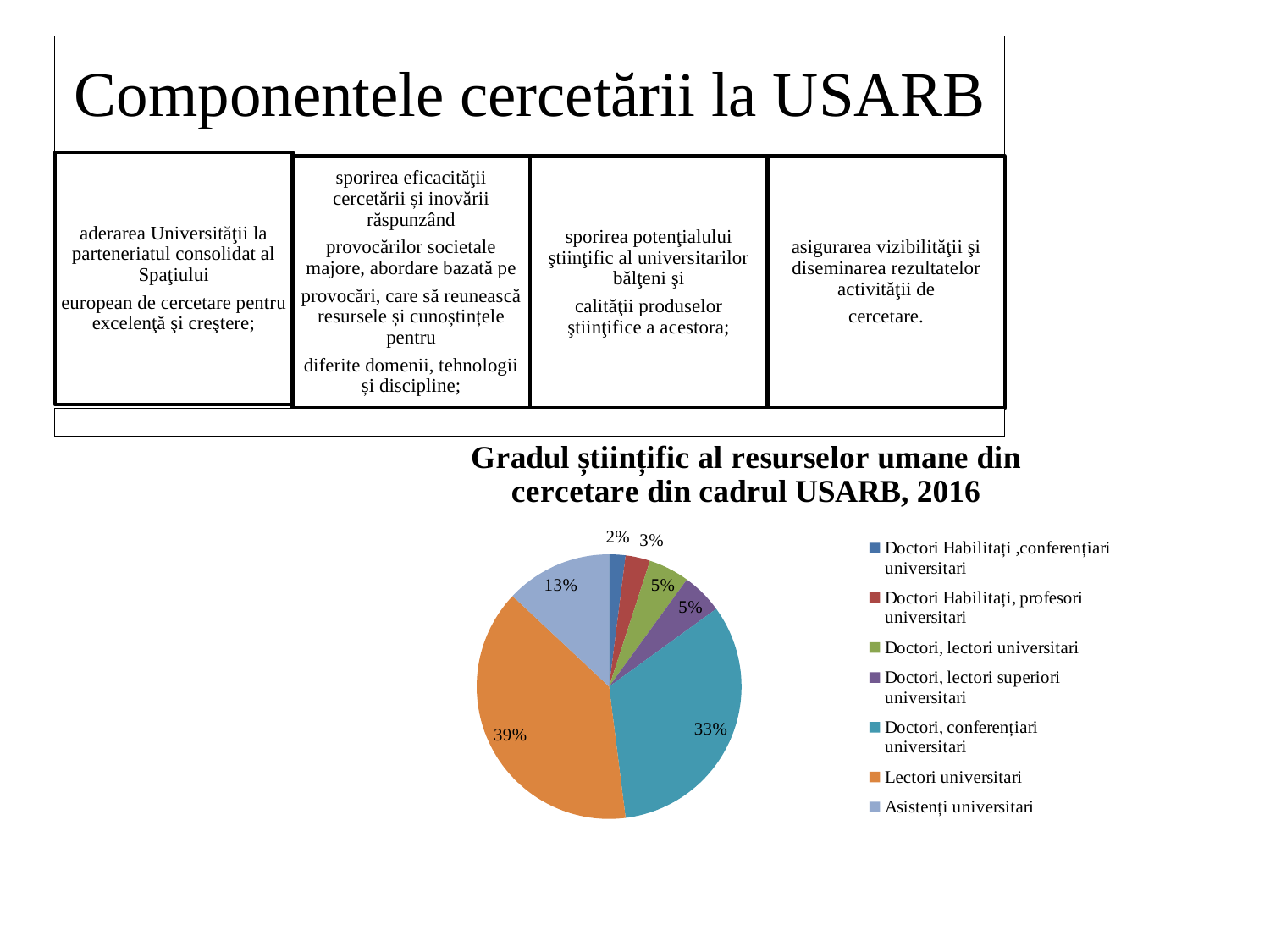
What share of the pie is Lectori universitari? 39% What share of the pie is Doctori Habilitați, profesori universitari? 3% What is the difference in percentage points between Lectori universitari and Doctori, conferențiari universitari? 6% What share of the pie is Asistenți universitari? 13% What is the title of the chart on the slide? Gradul științific al resurselor umane din cercetare din cadrul USARB, 2016 How many categories does the legend of the pie chart list? 7 Which category has the largest slice of the pie? Lectori universitari Which is larger: the share for Asistenți universitari or the share for Doctori, lectori universitari? Asistenți universitari Which category has the smallest slice of the pie? Doctori Habilitați, conferențiari universitari What type of chart is shown on the slide? Pie chart